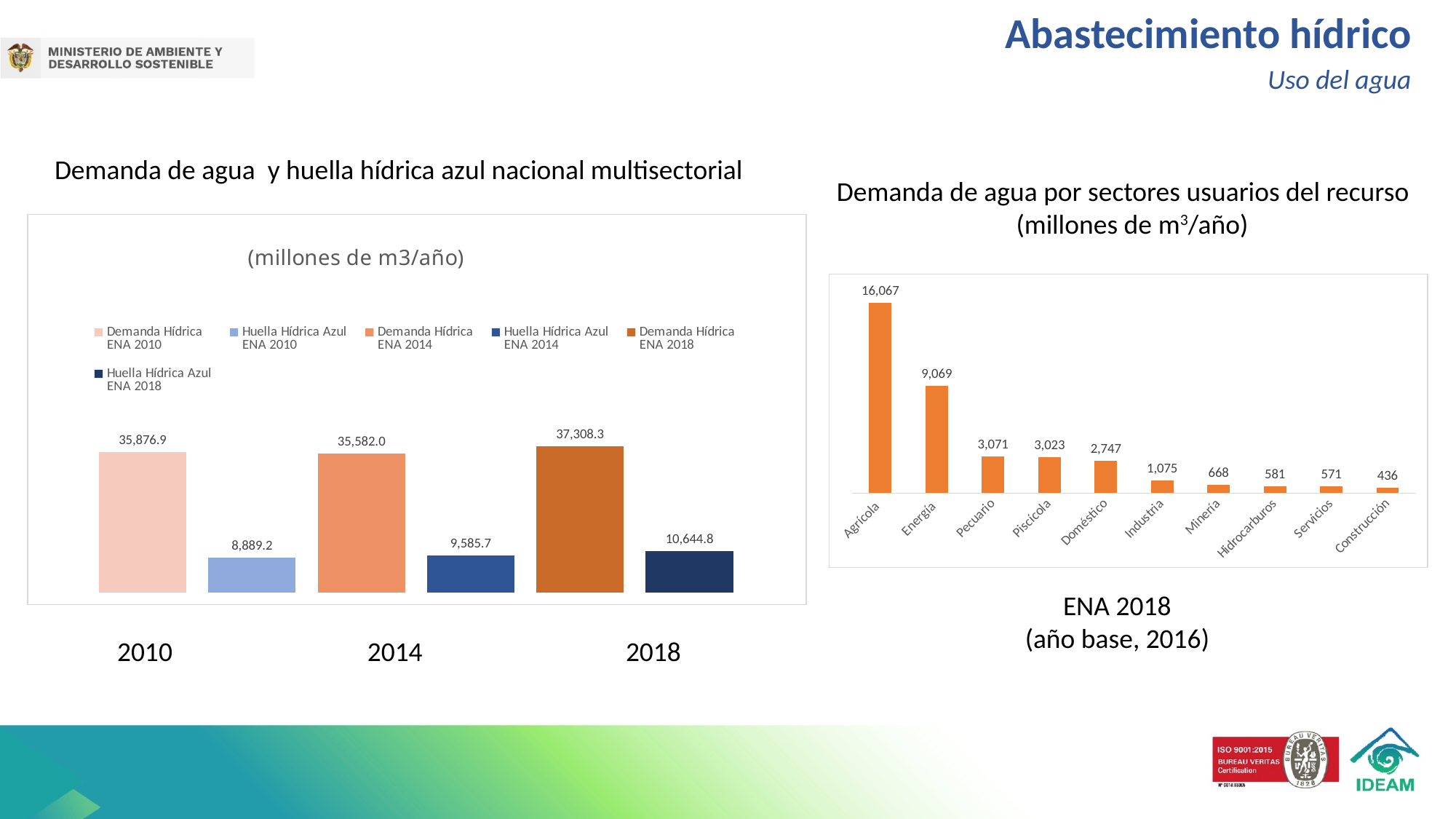
In the chart 'Demanda de agua y huella hídrica azul nacional multisectorial', does the Huella Hídrica Azul value rise or fall from 2010 to 2018? rise In the chart 'Demanda de agua y huella hídrica azul nacional multisectorial', what is the value of Demanda Hídrica ENA 2018? 37,308.3 In the chart 'Demanda de agua por sectores usuarios del recurso', which sector has the lowest value? Construcción In the chart 'Demanda de agua por sectores usuarios del recurso', how many sectors are shown? 10 In the chart 'Demanda de agua por sectores usuarios del recurso', what is the difference between Agrícola and Energía? 6,998 In the chart 'Demanda de agua y huella hídrica azul nacional multisectorial', how many series does the legend list? 6 In the chart 'Demanda de agua por sectores usuarios del recurso', which is larger, Pecuario or Piscícola? Pecuario In the chart 'Demanda de agua y huella hídrica azul nacional multisectorial', what is the value of Huella Hídrica Azul ENA 2010? 8,889.2 What type of chart is 'Demanda de agua por sectores usuarios del recurso'? bar chart In the chart 'Demanda de agua por sectores usuarios del recurso', what is the value for Agrícola? 16,067 In the chart 'Demanda de agua por sectores usuarios del recurso', what is the value for Doméstico? 2,747 In the chart 'Demanda de agua y huella hídrica azul nacional multisectorial', what is the difference between Demanda Hídrica ENA 2018 and Demanda Hídrica ENA 2014? 1,726.3